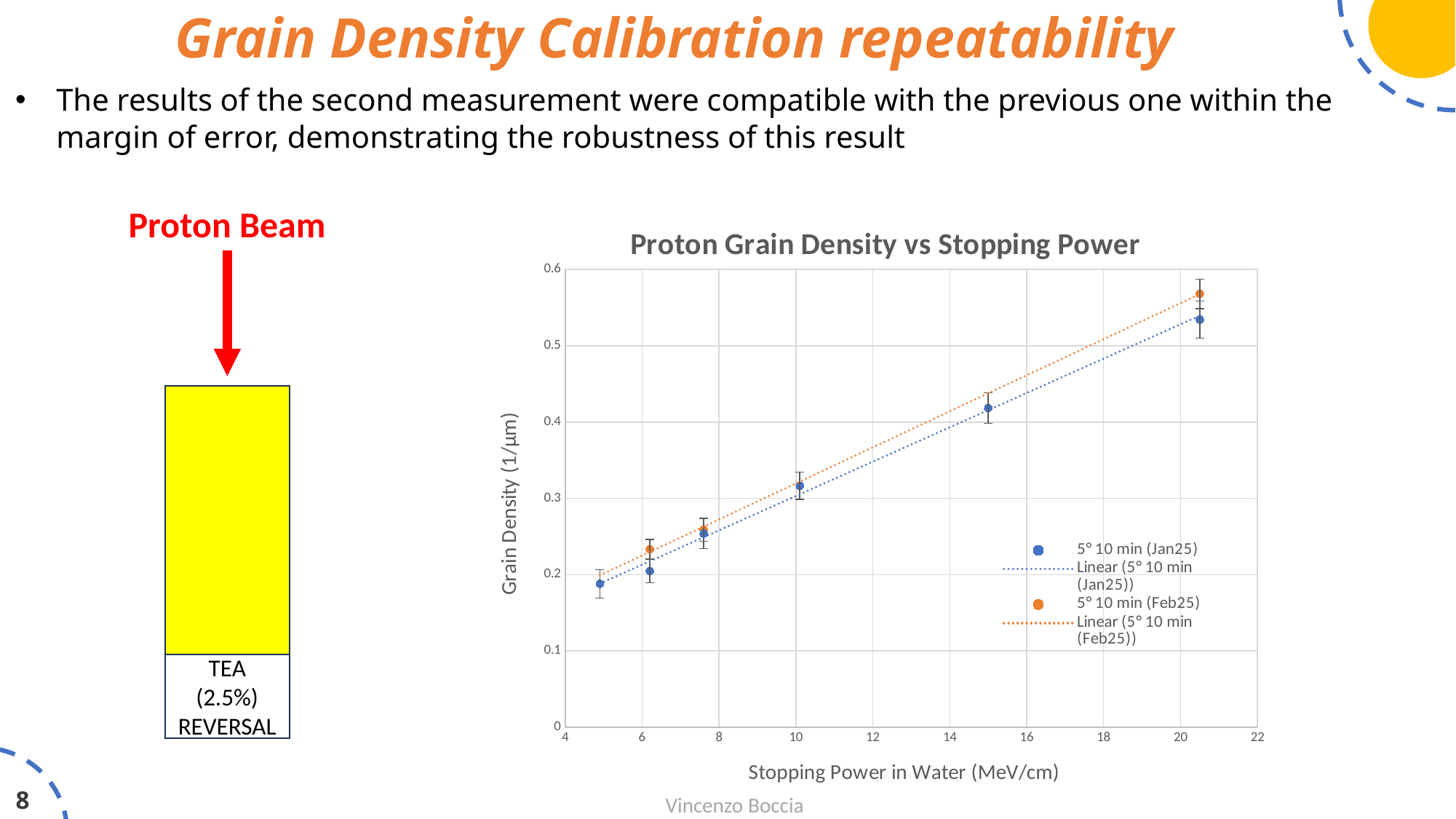
How many entries does the chart legend list? 4 How many data points are plotted for the 5° 10 min (Jan25) series? 6 Does grain density rise or fall as stopping power increases along the x axis? Rises What type of chart is shown on the slide? Scatter chart What is the label of the x axis of the chart? Stopping Power in Water (MeV/cm) Is the grain density of the 5° 10 min (Jan25) point at the lowest stopping power (around 5 MeV/cm) greater or less than 0.2? less Is the grain density of the 5° 10 min (Feb25) point at the highest stopping power (around 20.5 MeV/cm) greater or less than 0.5? greater Which series contains the point with the highest grain density on the chart? 5° 10 min (Feb25) Is the grain density of the 5° 10 min (Jan25) point at a stopping power of about 15 MeV/cm greater or less than 0.4? greater What is the title of the chart? Proton Grain Density vs Stopping Power At the highest stopping power (around 20.5 MeV/cm), which series has the higher grain density, 5° 10 min (Jan25) or 5° 10 min (Feb25)? 5° 10 min (Feb25)